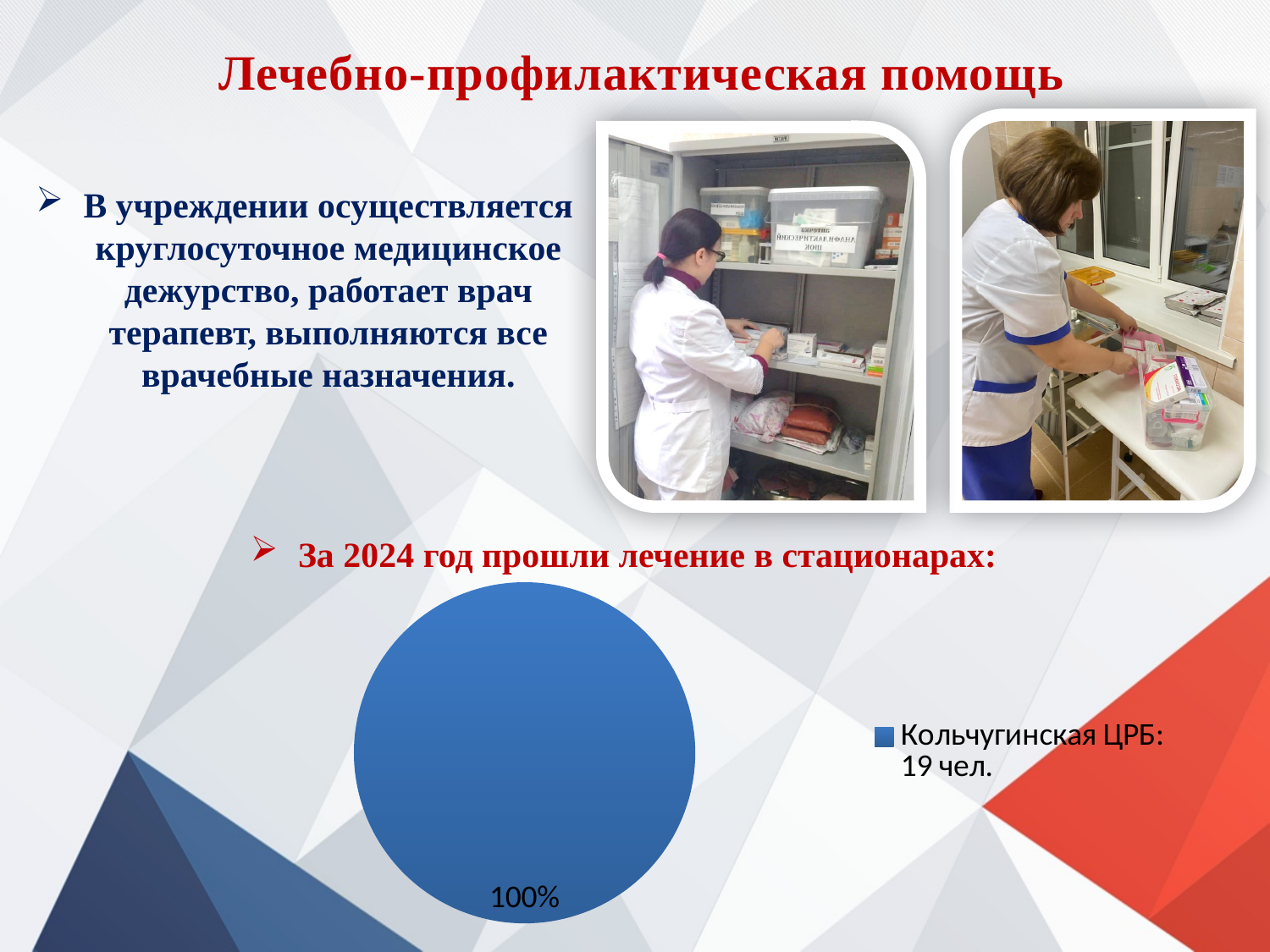
How many slices does the pie chart have? 1 How many entries does the legend of the pie chart list? 1 What is the legend entry of the pie chart? Кольчугинская ЦРБ: 19 чел. What kind of chart is shown on the slide? pie chart What percentage label is printed on the pie chart? 100% How many people does the legend say were treated at Кольчугинская ЦРБ? 19 чел. Is the share shown on the pie chart greater or less than 50%? greater What share of the pie does the slice for Кольчугинская ЦРБ represent? 100% What colour is the slice of the pie chart? blue